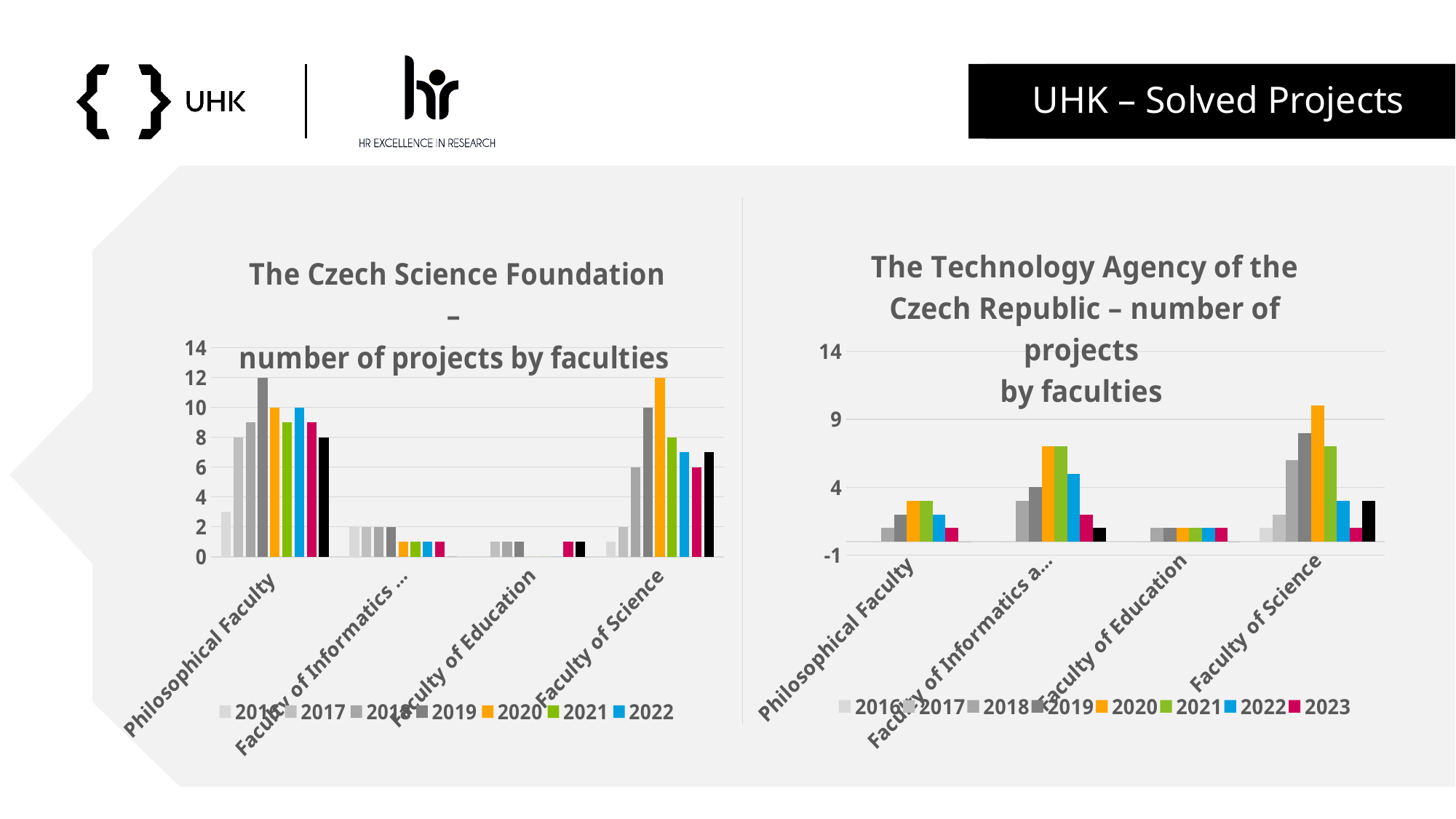
How many faculties are shown on the x axis of 'The Czech Science Foundation – number of projects by faculties' chart? 4 In 'The Technology Agency of the Czech Republic – number of projects by faculties' chart, which year has the highest value for the Faculty of Science? 2020 What kind of chart is 'The Czech Science Foundation – number of projects by faculties'? bar chart In 'The Czech Science Foundation – number of projects by faculties' chart, is the value for the Faculty of Education in 2019 greater or less than 2? less In 'The Technology Agency of the Czech Republic – number of projects by faculties' chart, is the value for the Faculty of Science in 2020 greater or less than 9? greater How many series does the legend list in 'The Czech Science Foundation – number of projects by faculties' chart? 7 How many series does the legend list in 'The Technology Agency of the Czech Republic – number of projects by faculties' chart? 8 In 'The Czech Science Foundation – number of projects by faculties' chart, what is the value for the Philosophical Faculty in 2019? 12 In 'The Czech Science Foundation – number of projects by faculties' chart, which faculty has the lowest values overall? Faculty of Education In 'The Czech Science Foundation – number of projects by faculties' chart, which year has the highest value for the Philosophical Faculty? 2019 In 'The Technology Agency of the Czech Republic – number of projects by faculties' chart, which is larger in 2020: the Faculty of Informatics or the Philosophical Faculty? Faculty of Informatics In 'The Czech Science Foundation – number of projects by faculties' chart, which year has the highest value for the Faculty of Science? 2020